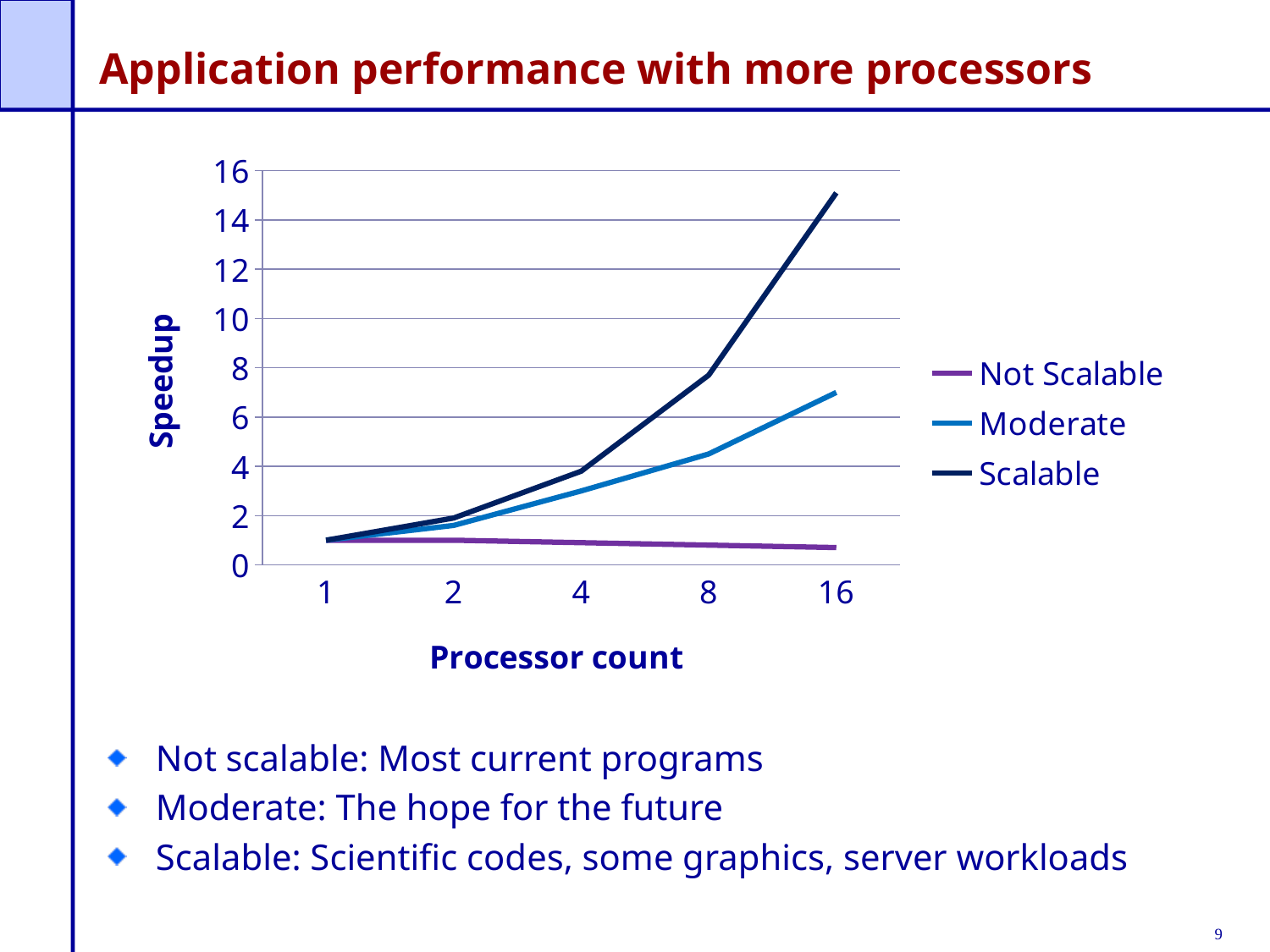
Which series has the highest speedup at a processor count of 16? Scalable Is the speedup for Moderate at 16 processors greater or less than 8? less Is the speedup for Scalable at 16 processors greater or less than 14? greater How many processor counts are plotted along the x axis? 5 Which series has the lowest speedup at a processor count of 16? Not Scalable Is the speedup for Scalable at 8 processors greater or less than 6? greater What is the title of the y axis? Speedup Does the speedup for Not Scalable rise or fall as the processor count increases? fall At a processor count of 8, which series has the larger speedup, Moderate or Not Scalable? Moderate How many series does the legend list? 3 What kind of chart is shown on the slide? line chart